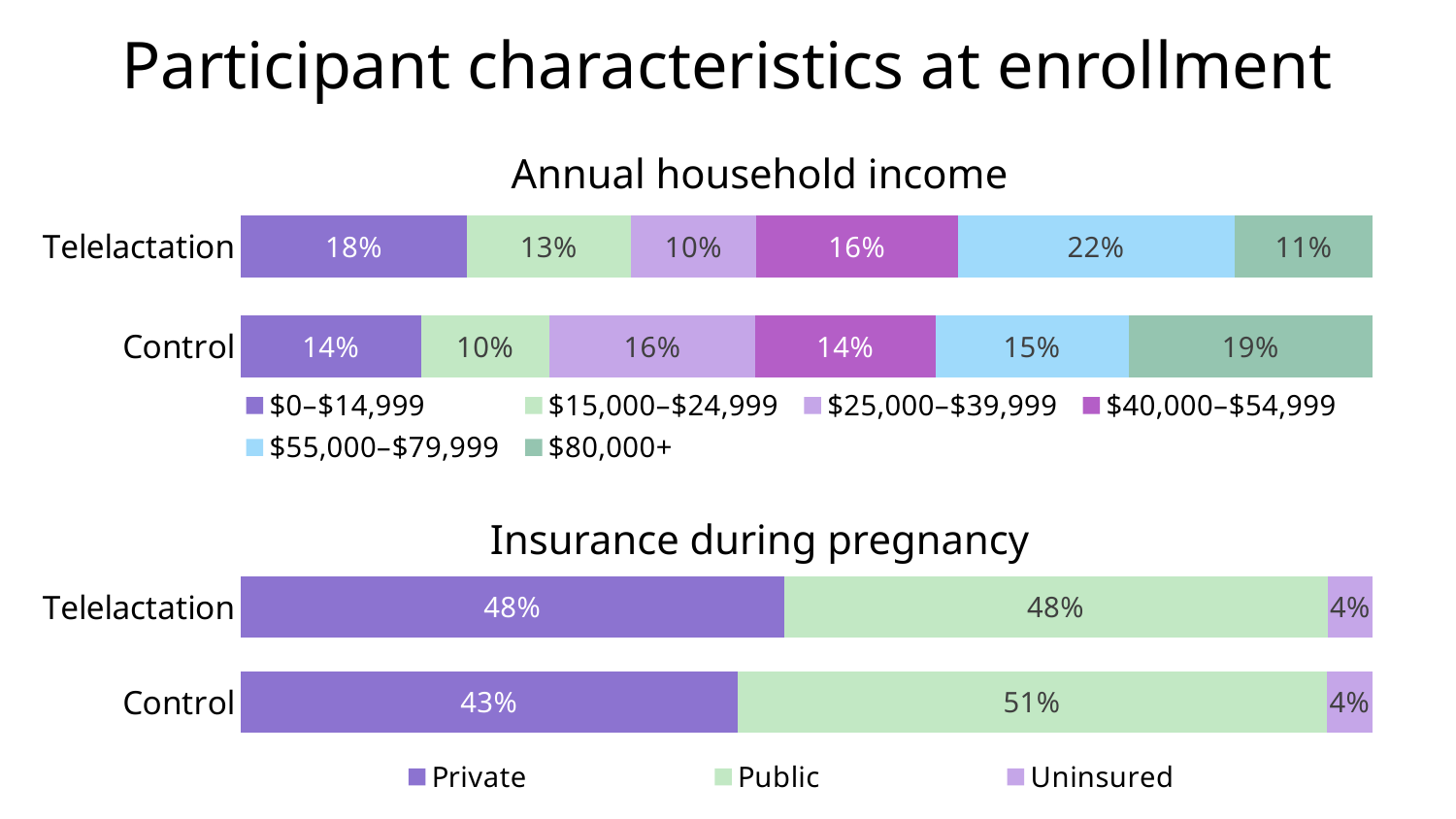
In the Insurance during pregnancy chart, what percentage of the Telelactation group was Uninsured? 4% How many income brackets does the legend of the Annual household income chart list? 6 In the Annual household income chart, what percentage of the Control group had an income of $80,000+? 19% What type of chart is the Insurance during pregnancy chart? Stacked bar chart In the Annual household income chart, what percentage of the Telelactation group had an income of $55,000–$79,999? 22% In the Insurance during pregnancy chart, what percentage of the Control group had Public insurance? 51% In the Annual household income chart, which income bracket has the largest share in the Telelactation group? $55,000–$79,999 In the Annual household income chart, which income bracket has the smallest share in the Control group? $15,000–$24,999 How many series does the legend of the Insurance during pregnancy chart list? 3 In the Insurance during pregnancy chart, what is the difference between the Public insurance shares of the Control and Telelactation groups? 3% In the Insurance during pregnancy chart, which group has the larger share of Private insurance, Telelactation or Control? Telelactation In the Annual household income chart, what is the difference between the Telelactation and Control shares for the $0–$14,999 bracket? 4%